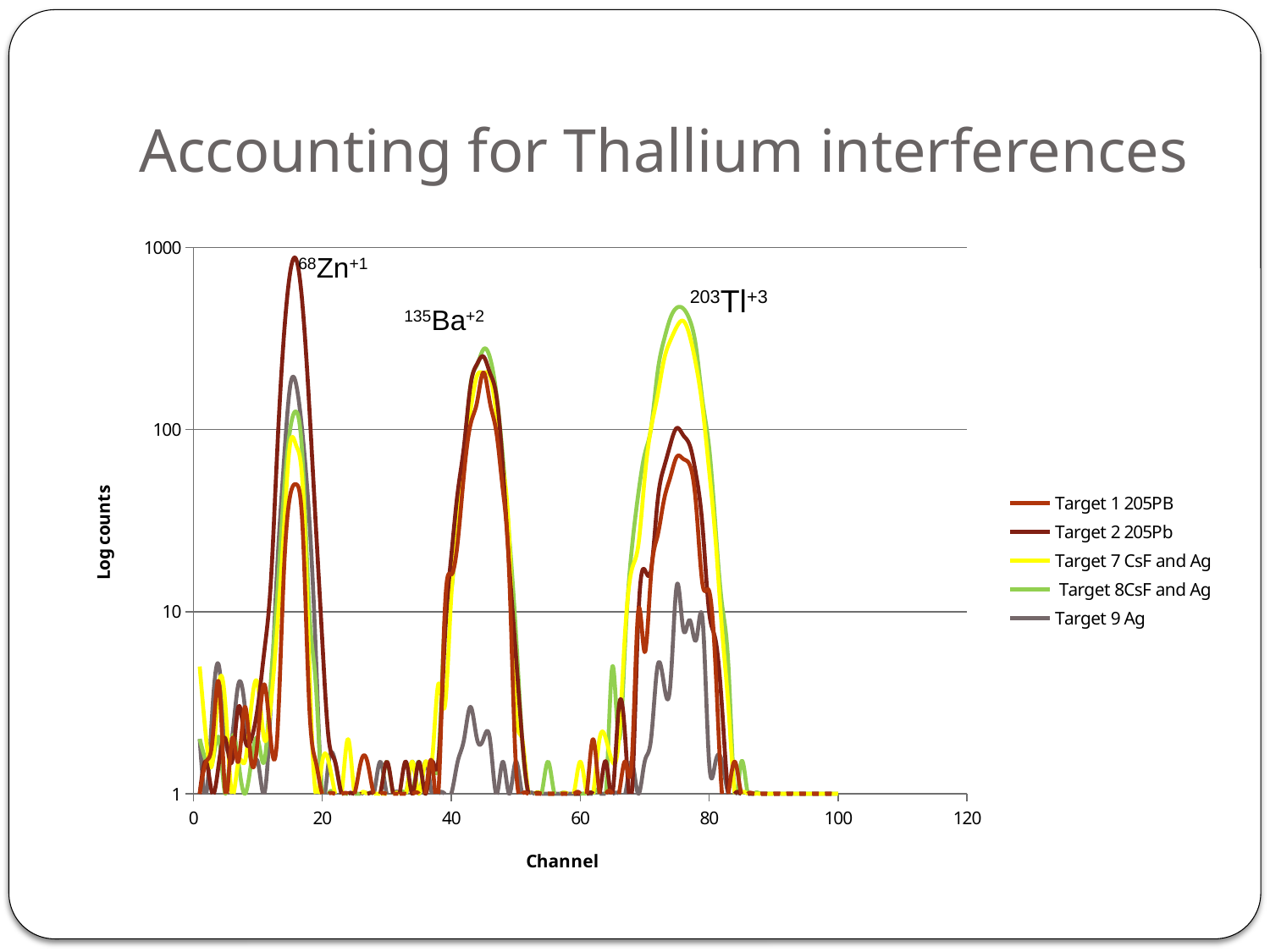
Is the highest peak near channel 15 greater or less than 100? greater What kind of chart is shown on the slide? line chart What is the highest value shown on the Channel axis? 120 What are the series names listed in the legend? Target 1 205PB, Target 2 205Pb, Target 7 CsF and Ag, Target 8CsF and Ag, Target 9 Ag How many labelled peaks are marked on the chart? 3 What is the title of the vertical axis? Log counts Is the peak value of Target 7 CsF and Ag near channel 75 greater or less than 100? greater Is the peak value of Target 9 Ag near channel 75 greater or less than 100? less Near channel 75, which series reaches a higher value: Target 9 Ag or Target 7 CsF and Ag? Target 7 CsF and Ag How many series does the legend list? 5 Near channel 15, which series reaches a higher value: Target 9 Ag or Target 1 205PB? Target 9 Ag